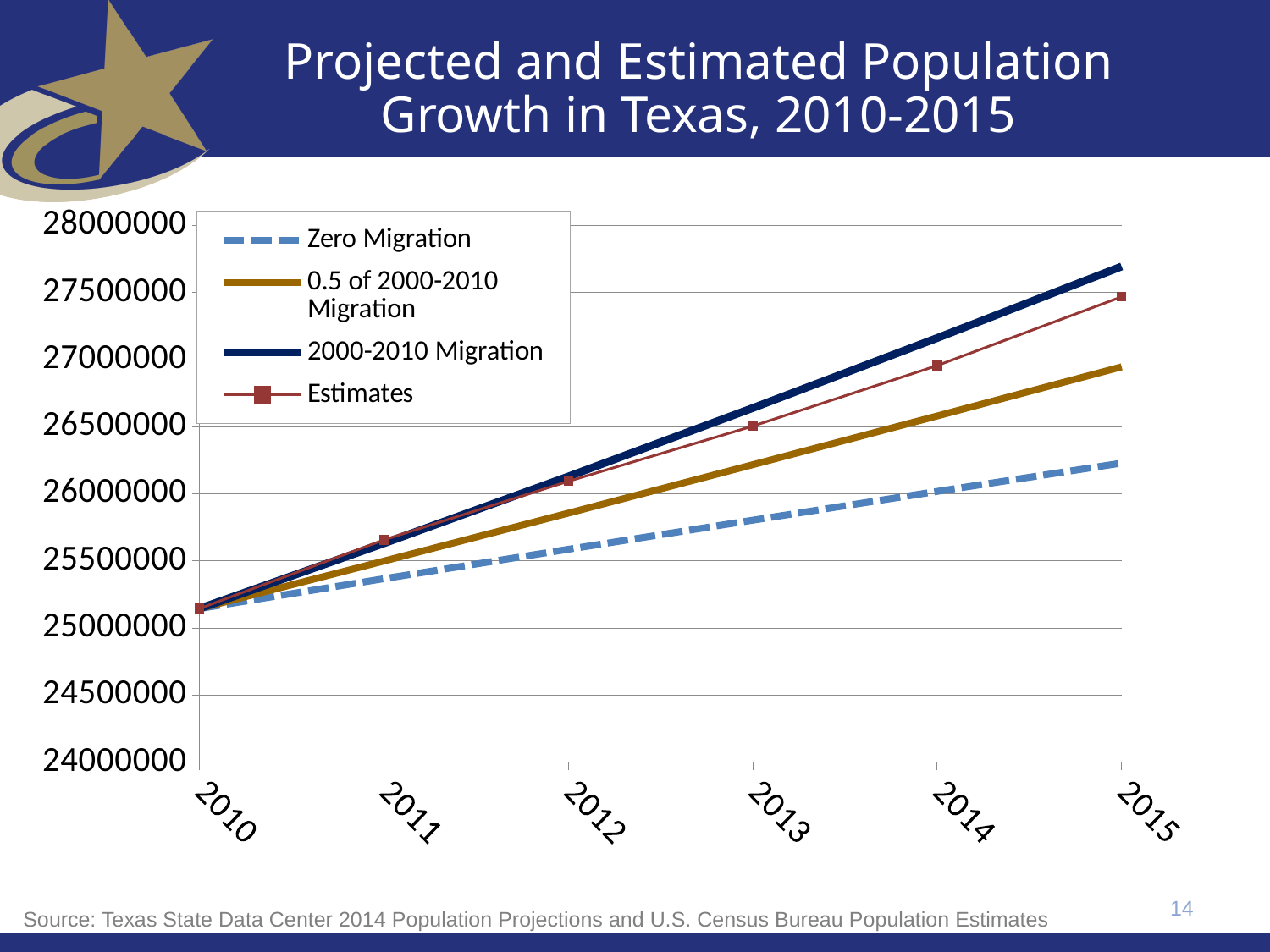
Is the value for 2000-2010 Migration in 2013 greater or less than 26500000? greater Is the value for Zero Migration in 2015 greater or less than 26000000? greater What kind of chart is shown on the slide? line chart Which series has the lowest value in 2015? Zero Migration What is the title of the chart? Projected and Estimated Population Growth in Texas, 2010-2015 How many series does the legend list? 4 In 2015, which is larger: the Estimates value or the 0.5 of 2000-2010 Migration value? Estimates Do the values for the Estimates series rise or fall from 2010 to 2015? rise Is the value for Zero Migration in 2012 greater or less than 25500000? greater Which series has the highest value in 2015? 2000-2010 Migration How many years are shown along the x axis? 6